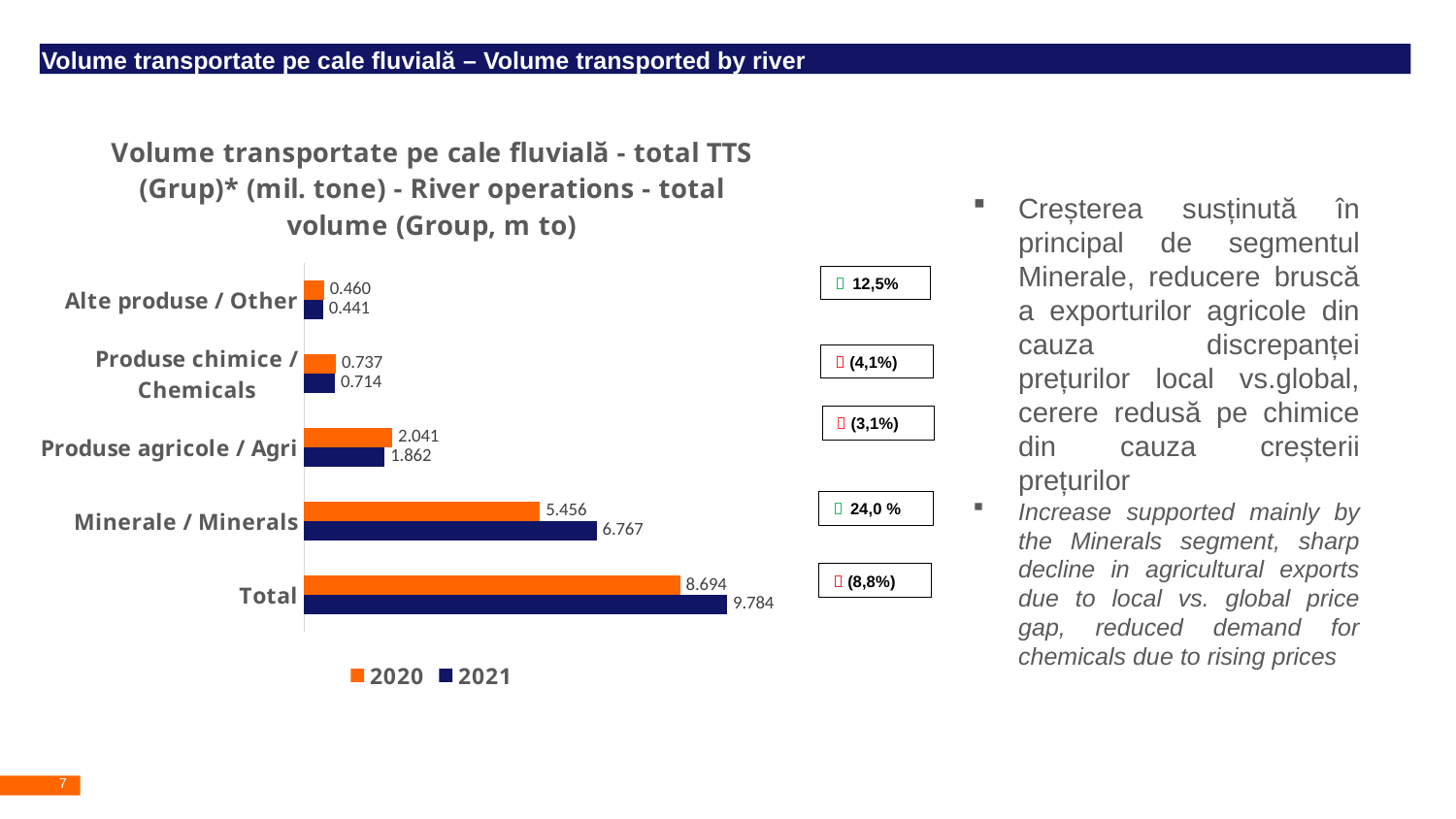
What was the 2020 value for Alte produse / Other? 0.460 What was the 2021 value for Total? 9.784 What was the 2020 value for Produse agricole / Agri? 2.041 What was the 2021 value for Minerale / Minerals? 6.767 How many categories are shown on the chart? 5 Excluding Total, which category had the highest 2021 value? Minerale / Minerals What is the difference between the 2021 and 2020 values for Total? 1.090 Which category had the lowest 2020 value? Alte produse / Other What kind of chart is shown on the slide? Bar chart What is the difference between the 2021 and 2020 values for Minerale / Minerals? 1.311 How many series does the legend list? 2 For Produse agricole / Agri, which year had the larger value, 2020 or 2021? 2020